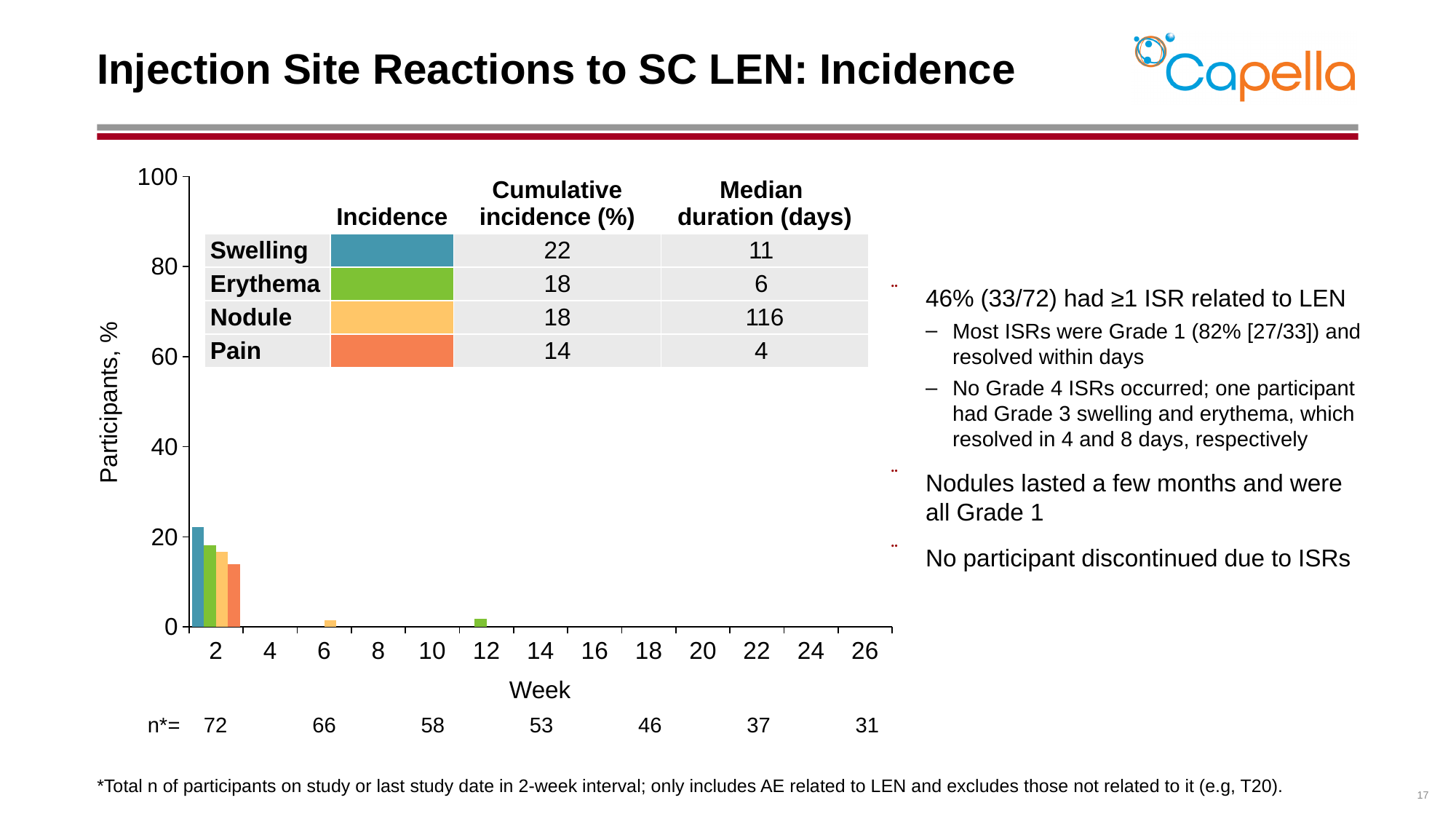
What is the median duration (days) for Nodule? 116 How many series does the chart's legend list? 4 Is the value for Pain at week 2 greater or less than 20? less At week 2, which bar is taller: Swelling or Pain? Swelling What is the difference in cumulative incidence (%) between Swelling and Pain? 8 Is the value for Swelling at week 2 greater or less than 20? greater What kind of chart is shown on the slide? bar chart Which reaction has the lowest cumulative incidence (%) in the legend table? Pain What is the label of the y axis? Participants, % Do the bar values rise or fall as the weeks increase along the x axis? fall What is the n* value shown under week 26? 31 Which reaction has the highest cumulative incidence (%) in the legend table? Swelling